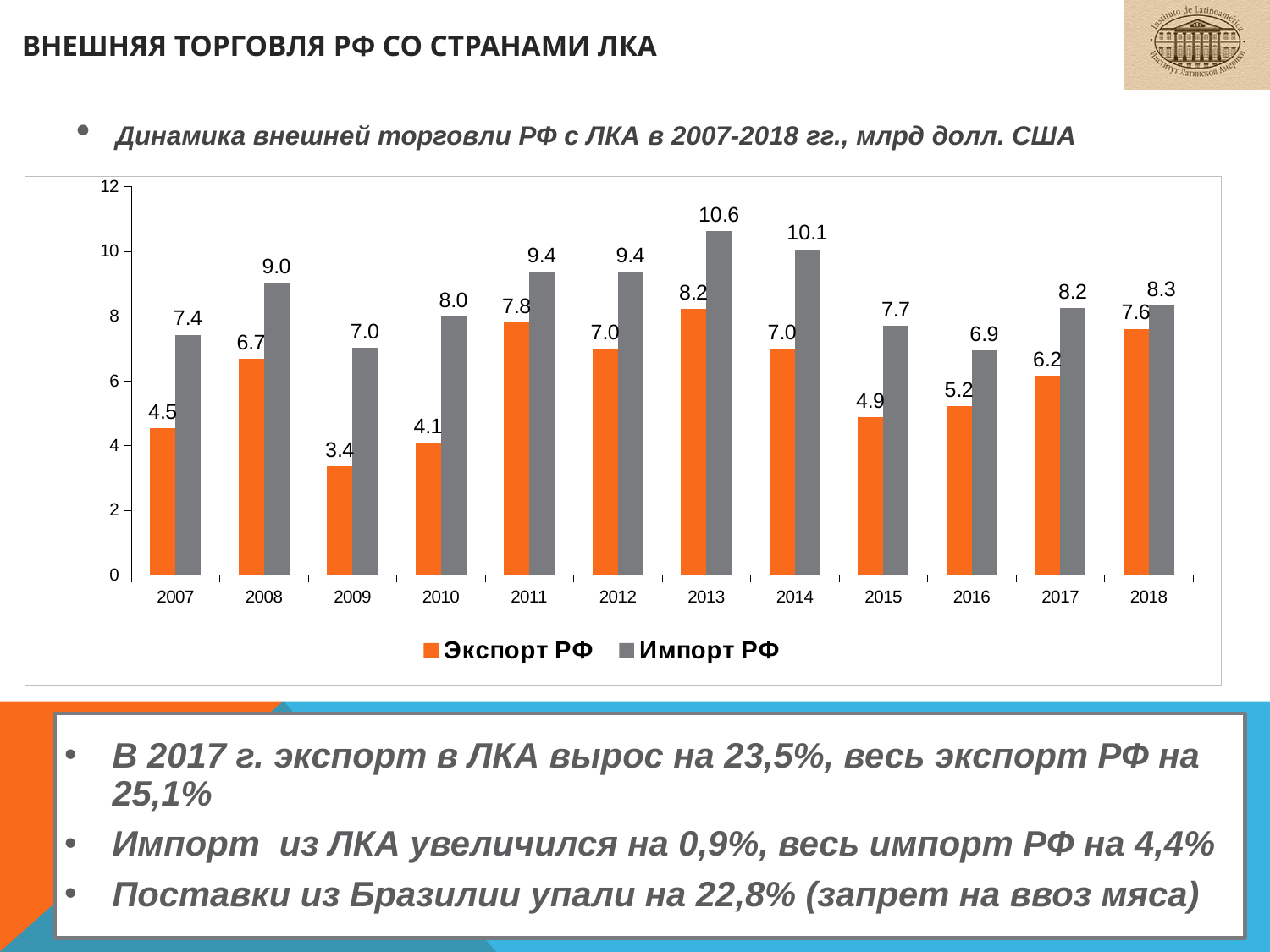
What kind of chart is shown on the slide? Bar chart How many years are shown on the x axis? 12 Which is larger in 2016: Экспорт РФ or Импорт РФ? Импорт РФ In which year is Экспорт РФ lowest? 2009 What is the value of Экспорт РФ in 2013? 8.2 What is the value of Импорт РФ in 2010? 8.0 How many series does the legend list? 2 What is the difference between Импорт РФ and Экспорт РФ in 2014? 3.1 In which year is Импорт РФ highest? 2013 Which colour represents Экспорт РФ in the chart? Orange Is the value of Импорт РФ in 2013 greater or less than 10? greater Does Экспорт РФ rise or fall from 2015 to 2018? Rise